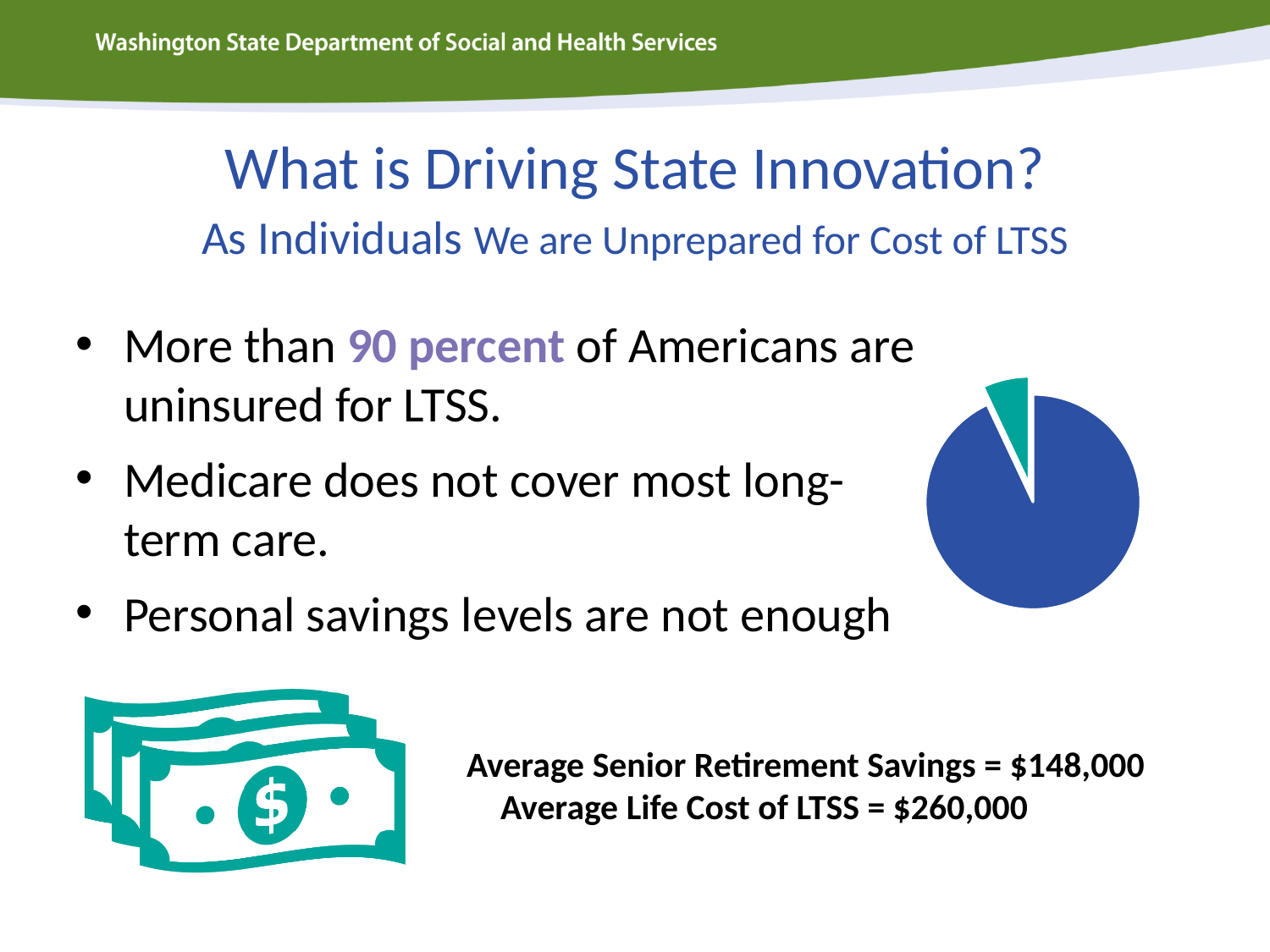
Which colour slice is the largest in the pie chart? blue Which slice of the pie chart is pulled out (exploded) from the rest of the pie? the teal slice Does the pie chart have a legend? No How many slices does the pie chart have? 2 What kind of chart is shown on the right side of the slide? pie chart Which colour slice is the smallest in the pie chart? teal Which slice of the pie chart is larger, the blue slice or the teal slice? the blue slice